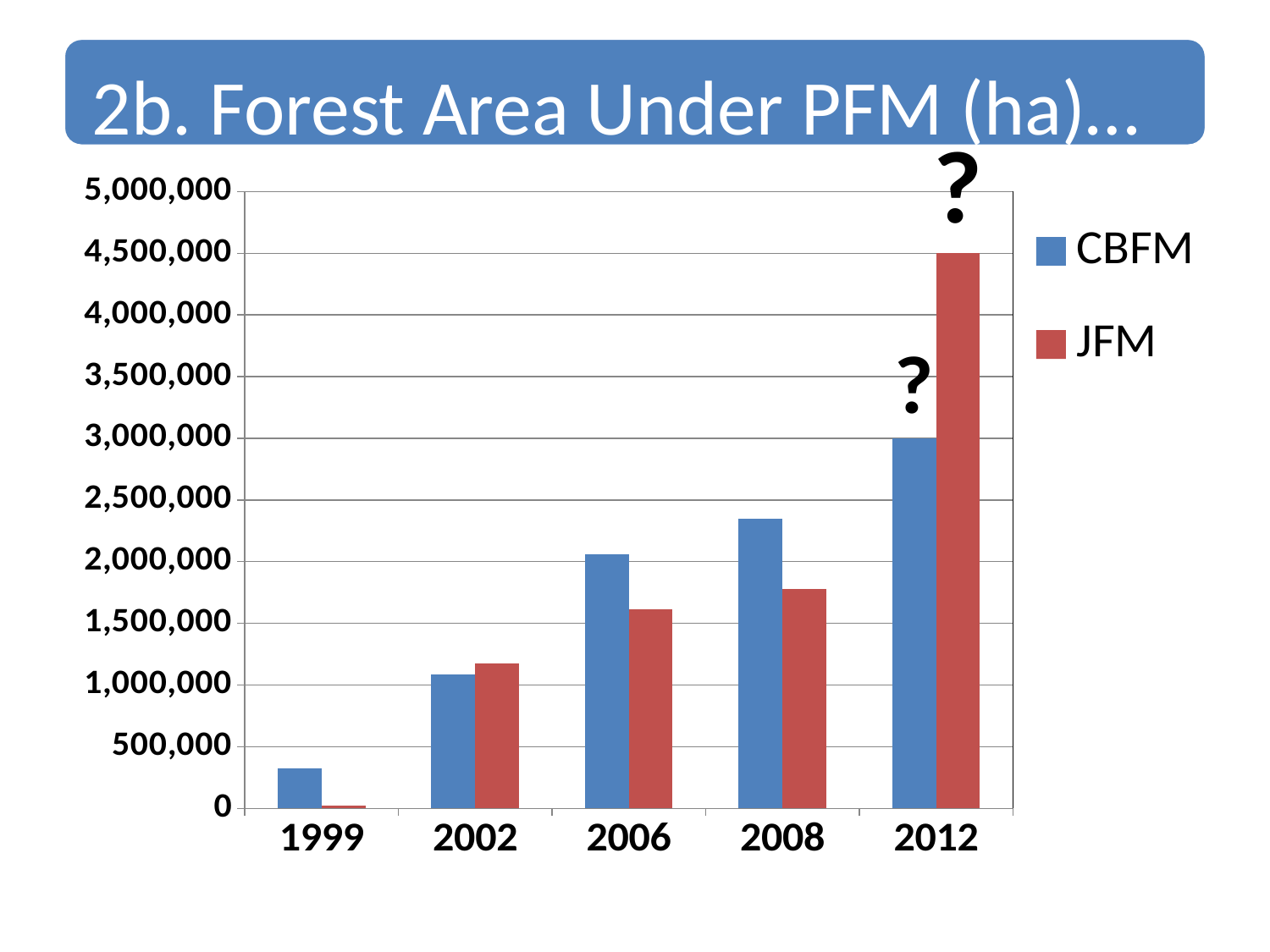
In which year is the CBFM value highest? 2012 Do the CBFM values rise or fall from 1999 to 2012? rise What kind of chart is shown on the slide? bar chart How many years are shown on the x axis? 5 Is the CBFM value for 2008 greater or less than 2,000,000? greater What colour represents JFM in the legend? red Is the JFM value for 1999 greater or less than 500,000? less What is the JFM value for 2012? 4,500,000 In 2006, which series has the larger value, CBFM or JFM? CBFM In 2002, which series has the larger value, CBFM or JFM? JFM How many series does the legend list? 2 In which year is the JFM value lowest? 1999